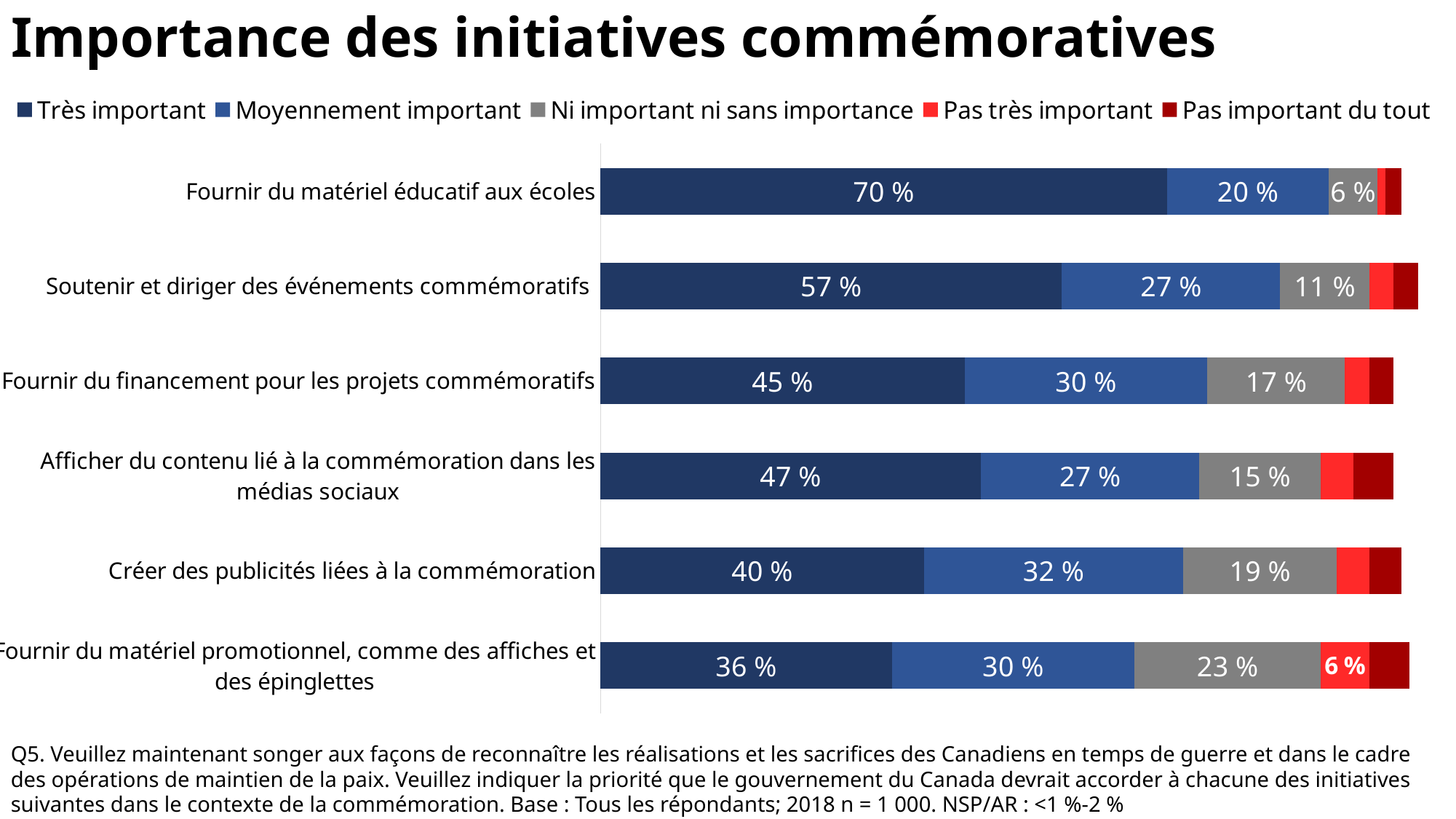
What is the 'Moyennement important' value for 'Soutenir et diriger des événements commémoratifs'? 27 % How many series does the legend list? 5 Which initiative has the lowest 'Très important' value? Fournir du matériel promotionnel, comme des affiches et des épinglettes What is the difference between the 'Très important' values for 'Fournir du matériel éducatif aux écoles' and 'Soutenir et diriger des événements commémoratifs'? 13 % Which is larger: the 'Moyennement important' value for 'Créer des publicités liées à la commémoration' or for 'Fournir du financement pour les projets commémoratifs'? Créer des publicités liées à la commémoration What is the 'Pas très important' value for 'Fournir du matériel promotionnel, comme des affiches et des épinglettes'? 6 % Which initiative has the highest 'Très important' value? Fournir du matériel éducatif aux écoles How many initiatives (categories) are shown in the chart? 6 What is the title of the chart? Importance des initiatives commémoratives What kind of chart is shown on the slide? Stacked bar chart What is the 'Très important' value for 'Fournir du matériel éducatif aux écoles'? 70 % What is the 'Ni important ni sans importance' value for 'Fournir du matériel promotionnel, comme des affiches et des épinglettes'? 23 %